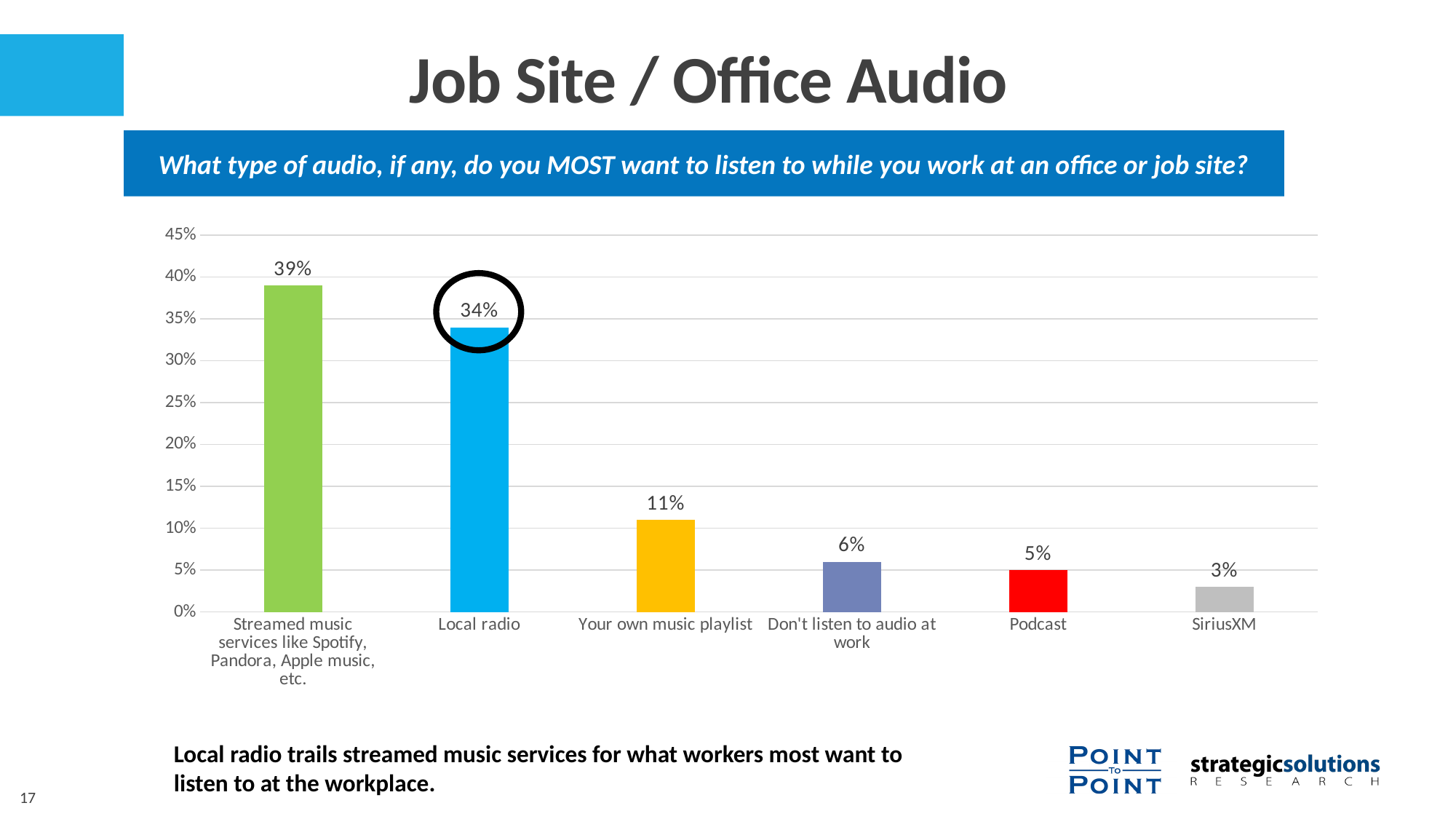
Which bar on the chart is circled? Local radio Which is larger, the value for Your own music playlist or the value for Podcast? Your own music playlist Do the values rise or fall moving from left to right along the x axis? Fall What is the value shown for Podcast? 5% What percentage of workers don't listen to audio at work? 6% What is the value shown for SiriusXM? 3% Which category has the lowest value? SiriusXM What percentage of workers most want to listen to local radio while at work? 34% What is the difference between the value for streamed music services and the value for local radio? 5% What kind of chart is shown on the slide? Bar chart Which category has the highest value? Streamed music services like Spotify, Pandora, Apple music, etc. How many categories are shown on the chart? 6